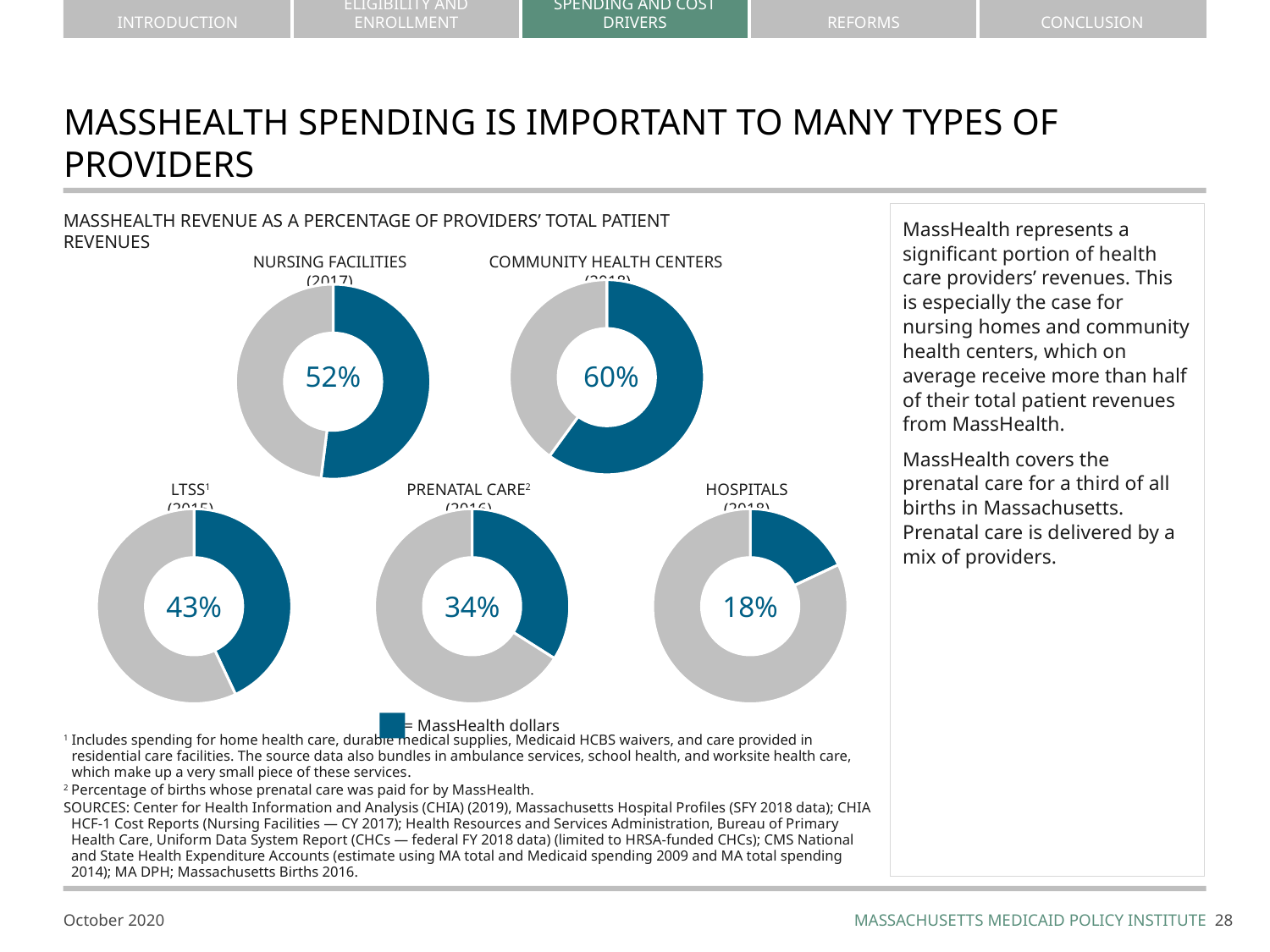
In the Prenatal Care donut chart, what percentage is shown? 34% In the LTSS donut chart, what percentage is shown? 43% What kind of chart is used to show MassHealth revenue as a percentage of providers' total patient revenues? Donut (pie) chart In the Community Health Centers donut chart, what percentage is shown for MassHealth revenue? 60% What is the difference in percentage points between the Community Health Centers chart (60%) and the Hospitals chart (18%)? 42 percentage points Across the five donut charts on the slide, which provider type has the highest MassHealth share of revenues? Community Health Centers According to the legend below the charts, what does the blue segment in each donut represent? MassHealth dollars In the Nursing Facilities donut chart, what percentage of total patient revenues comes from MassHealth? 52% Across the five donut charts on the slide, which provider type has the lowest MassHealth share of revenues? Hospitals How many donut charts are shown on the slide? 5 In the Hospitals donut chart, what percentage of total patient revenues comes from MassHealth? 18% Which is larger: the MassHealth share shown in the Nursing Facilities chart or in the LTSS chart? Nursing Facilities